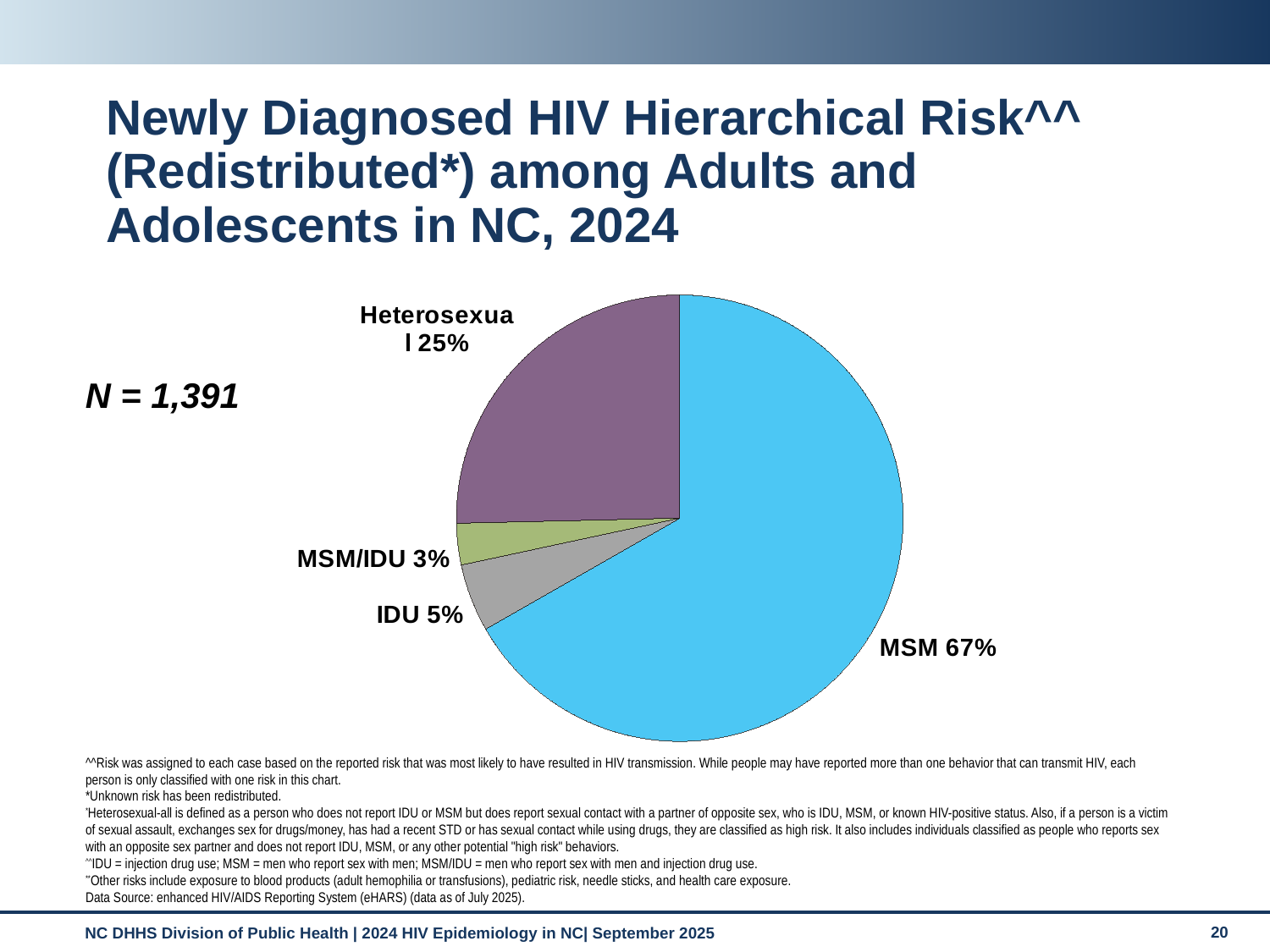
Which is larger, the IDU share or the MSM/IDU share? IDU What is the difference in percentage points between the IDU and MSM/IDU shares? 2 What is the total N shown next to the chart? N = 1,391 How many risk categories are shown in the pie chart? 4 What is the difference in percentage points between the MSM and Heterosexual shares? 42 What share of the pie is IDU? 5% What share of the pie is MSM/IDU? 3% Which risk category has the largest share of the pie? MSM What share of the pie is MSM? 67% What kind of chart is shown on the slide? Pie chart What share of the pie is Heterosexual? 25% Which risk category has the smallest share of the pie? MSM/IDU